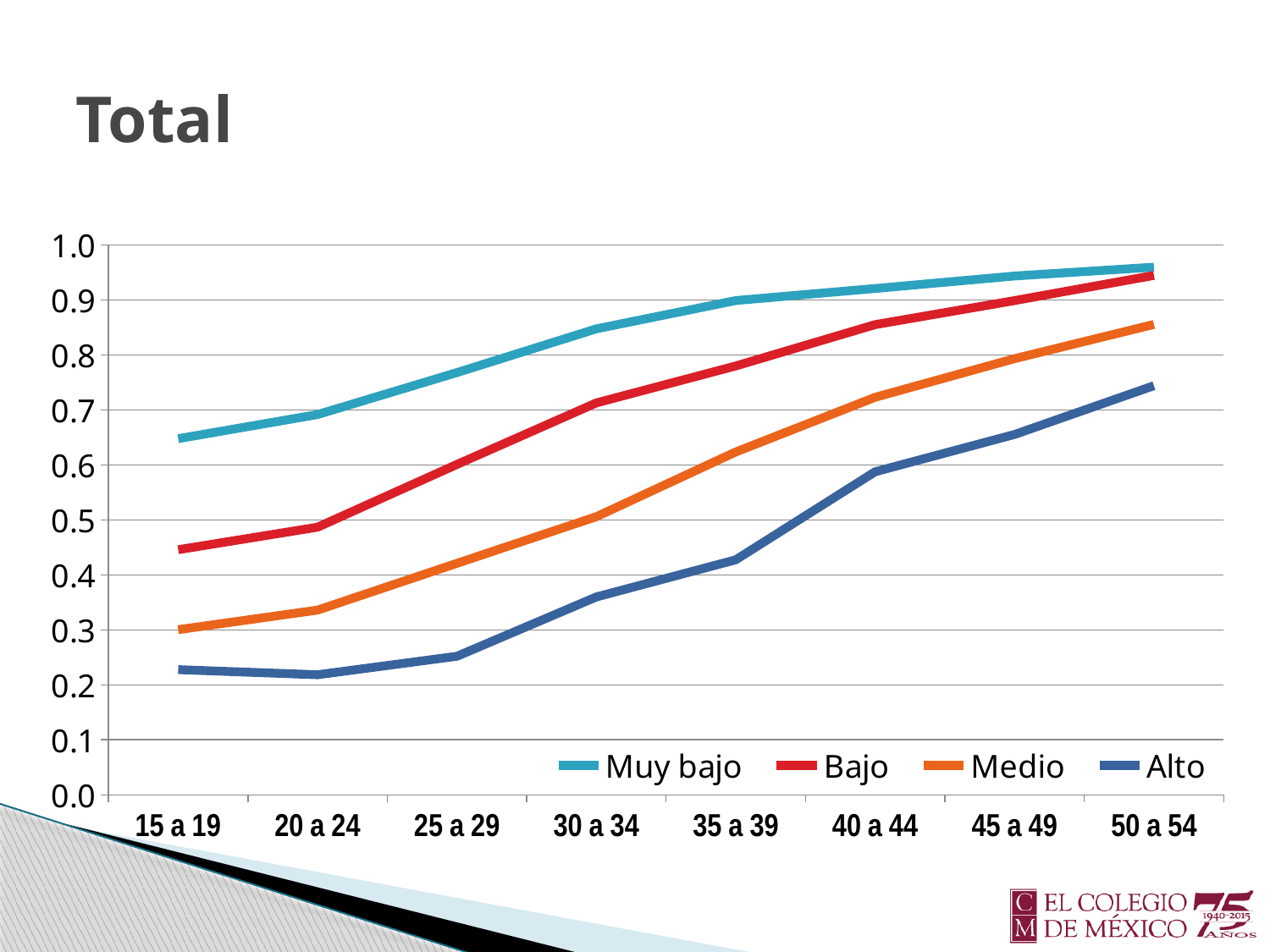
Which series has the lowest value at 30 a 34? Alto At 25 a 29, which is larger: Bajo or Medio? Bajo Is the value for Alto at 15 a 19 greater or less than 0.3? less What kind of chart is shown on the slide? line chart How many series does the legend list? 4 What is the title of the slide? Total Which series has the highest value at 15 a 19? Muy bajo Is the value for Muy bajo at 30 a 34 greater or less than 0.8? greater Does the Muy bajo series rise or fall from 15 a 19 to 50 a 54? rise How many age-group categories are shown on the x axis? 8 Is the value for Medio at 35 a 39 greater or less than 0.5? greater